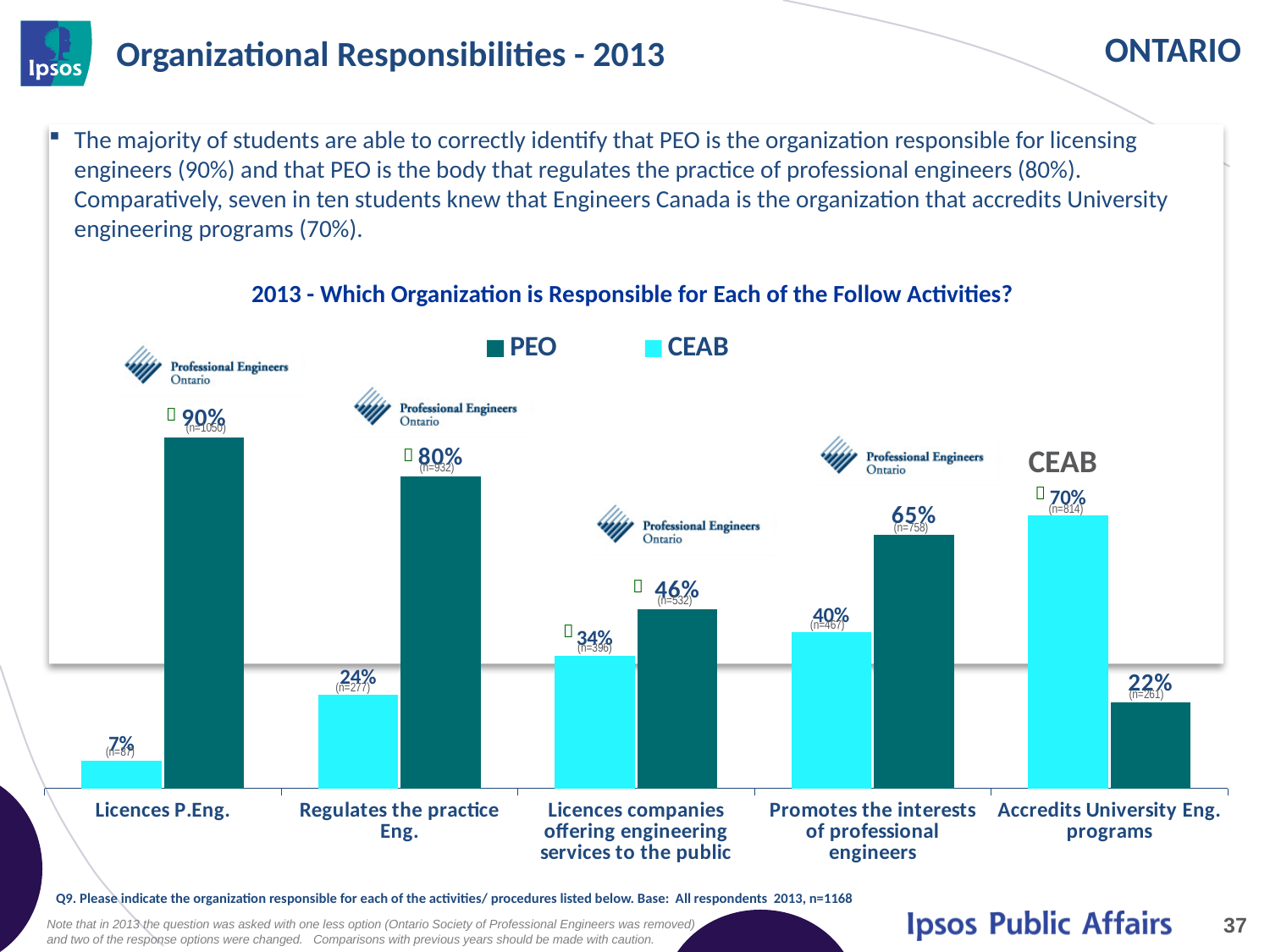
How many series does the chart legend list? 2 For 'Accredits University Eng. programs', which is larger, the PEO value or the CEAB value? CEAB What is the CEAB value for 'Regulates the practice Eng.'? 24% For which activity is the PEO value highest? Licences P.Eng. What is the PEO value for 'Promotes the interests of professional engineers'? 65% For which activity is the CEAB value lowest? Licences P.Eng. What kind of chart is shown on the slide? Bar chart What percentage of students said CEAB accredits University Eng. programs? 70% What is the title of the chart? 2013 - Which Organization is Responsible for Each of the Follow Activities? How many activities are shown on the x axis of the chart? 5 What percentage of students said PEO licences P.Eng.? 90% What is the difference between the PEO and CEAB values for 'Licences companies offering engineering services to the public'? 12 percentage points